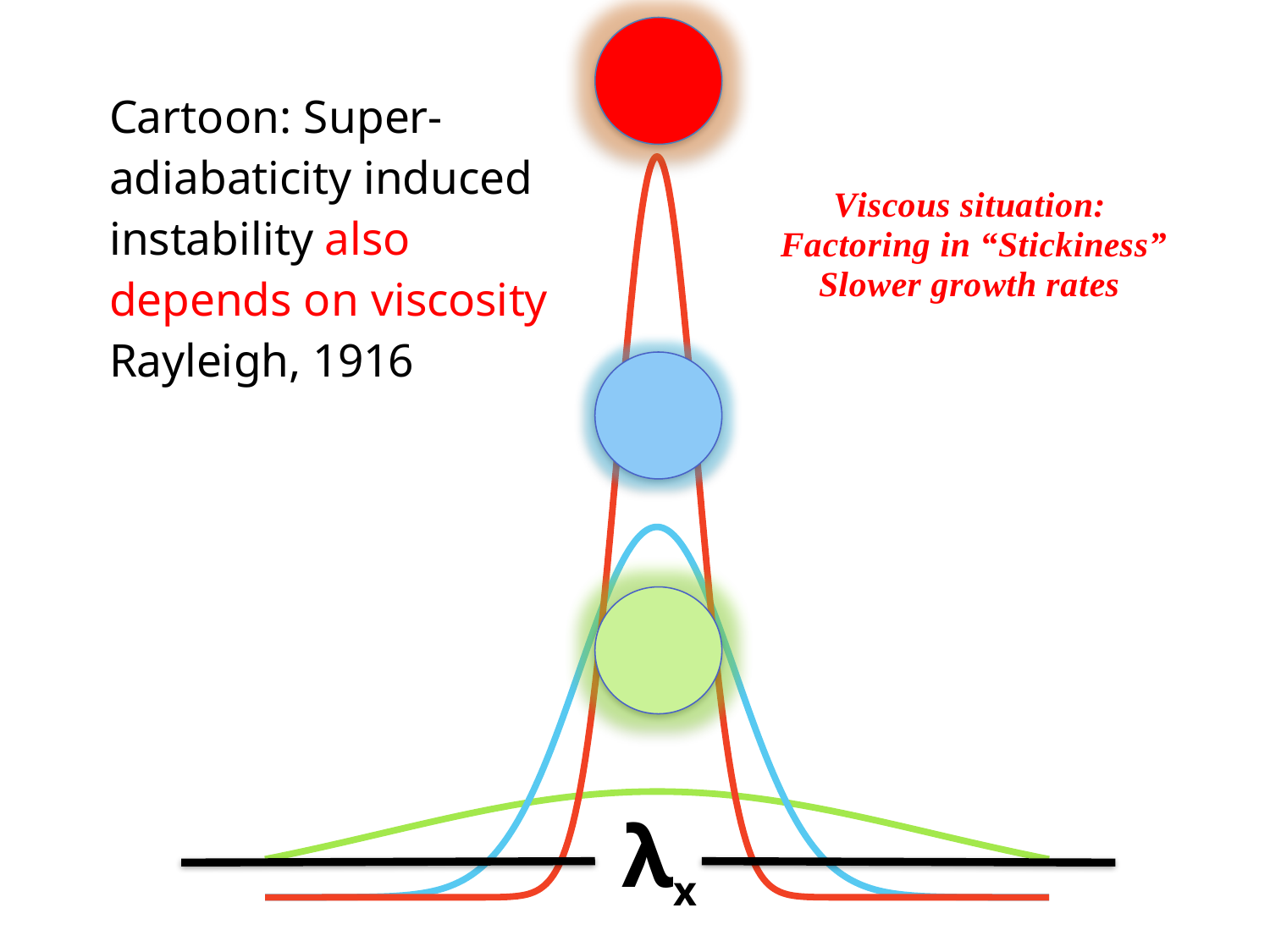
Which coloured curve has the lowest peak in the diagram? Green What colour is the circle drawn at the top of the tallest curve? Red How many curves are plotted above the horizontal axis in the diagram? 3 Which curve is the widest (most spread out) along the horizontal axis? Green What label is written on the horizontal axis of the diagram? λx Which coloured curve reaches the highest peak in the diagram? Red Which curve peaks higher, the blue curve or the green curve? Blue